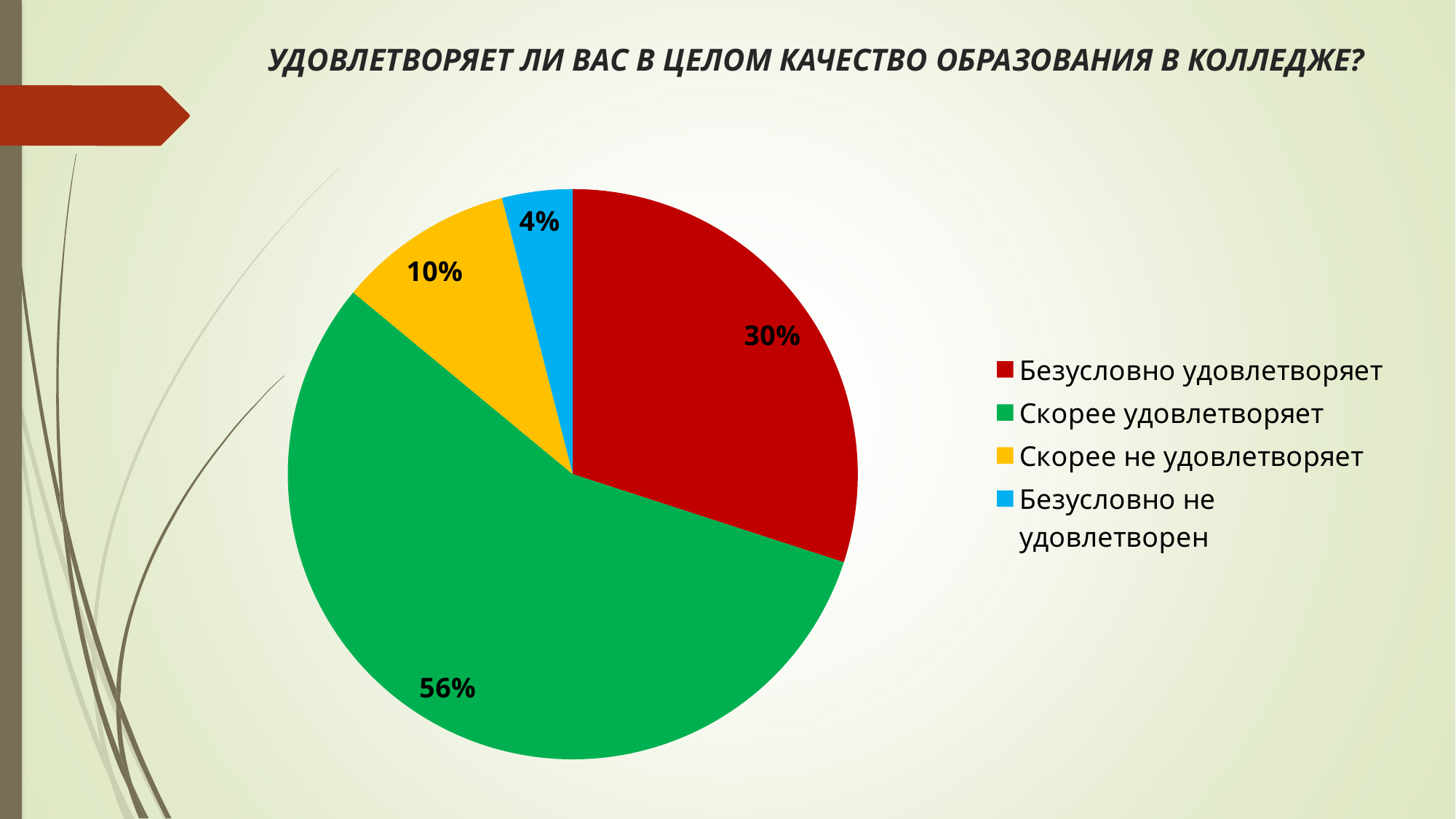
Which is larger: "Скорее не удовлетворяет" or "Безусловно не удовлетворен"? Скорее не удовлетворяет What colour is the slice for "Безусловно удовлетворяет"? Red Which category has the largest slice? Скорее удовлетворяет How many categories does the pie chart show? 4 What is the difference between "Скорее удовлетворяет" and "Безусловно удовлетворяет"? 26% Which category has the smallest slice? Безусловно не удовлетворен What is the value for "Безусловно не удовлетворен"? 4% What is the title of the chart? УДОВЛЕТВОРЯЕТ ЛИ ВАС В ЦЕЛОМ КАЧЕСТВО ОБРАЗОВАНИЯ В КОЛЛЕДЖЕ? What is the value for "Скорее не удовлетворяет"? 10% What is the value for "Безусловно удовлетворяет"? 30% What share of the pie does "Скорее удовлетворяет" take? 56% What kind of chart is shown on the slide? Pie chart